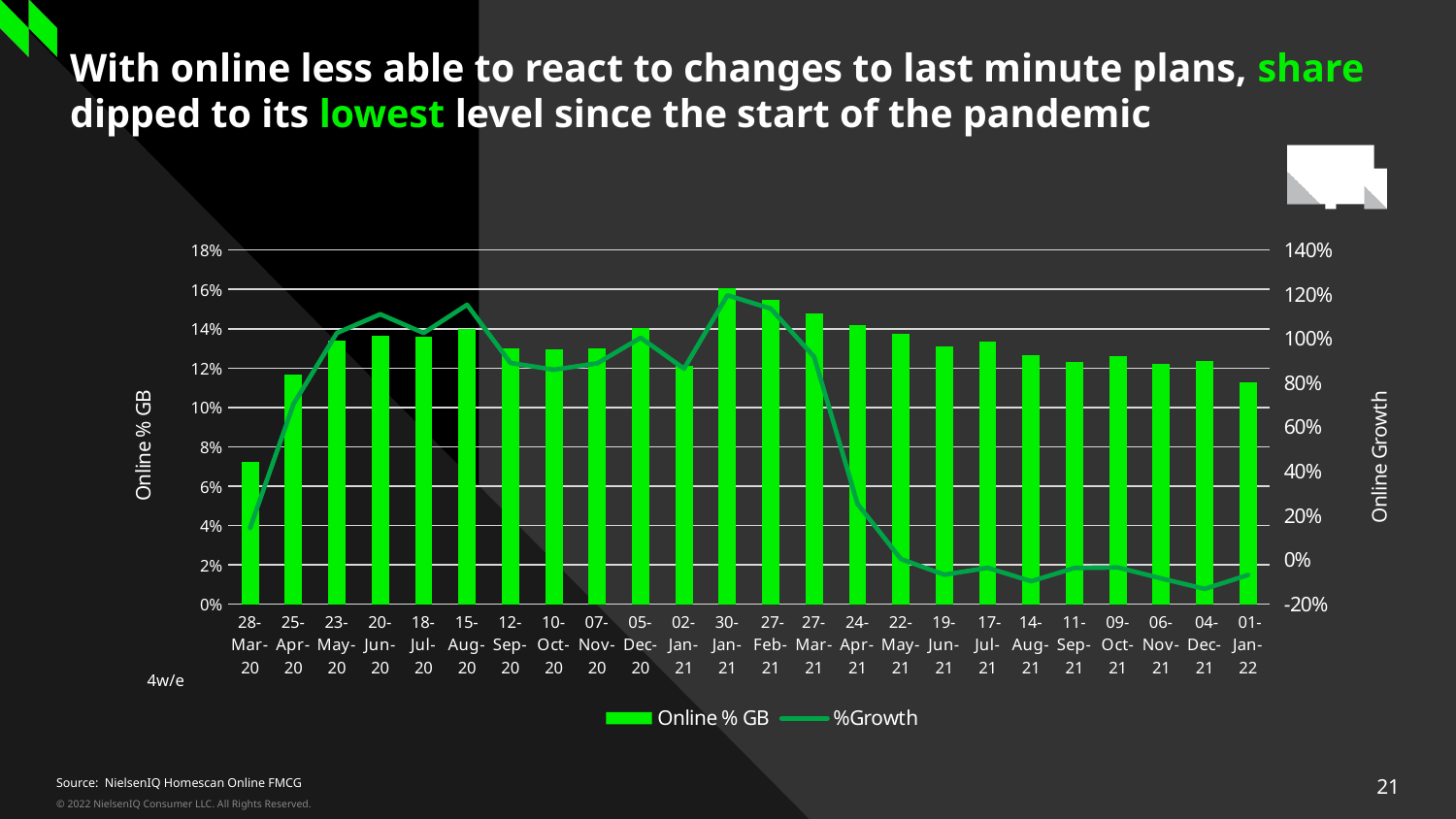
How many 4w/e periods are shown on the x axis? 24 What are the two series named in the legend? Online % GB and %Growth How many series does the legend list? 2 Is the Online % GB value for 01-Jan-22 greater or less than 12%? less Which has the larger Online % GB bar, 30-Jan-21 or 01-Jan-22? 30-Jan-21 Is the Online % GB value for 30-Jan-21 greater or less than 14%? greater Which period has the highest Online % GB bar? 30-Jan-21 What kind of chart is shown on the slide? A combined bar and line chart Is the %Growth value for 30-Jan-21 greater or less than 100%? greater Which period has the lowest Online % GB bar? 28-Mar-20 Does the %Growth line rise or fall between 27-Mar-21 and 19-Jun-21? Fall